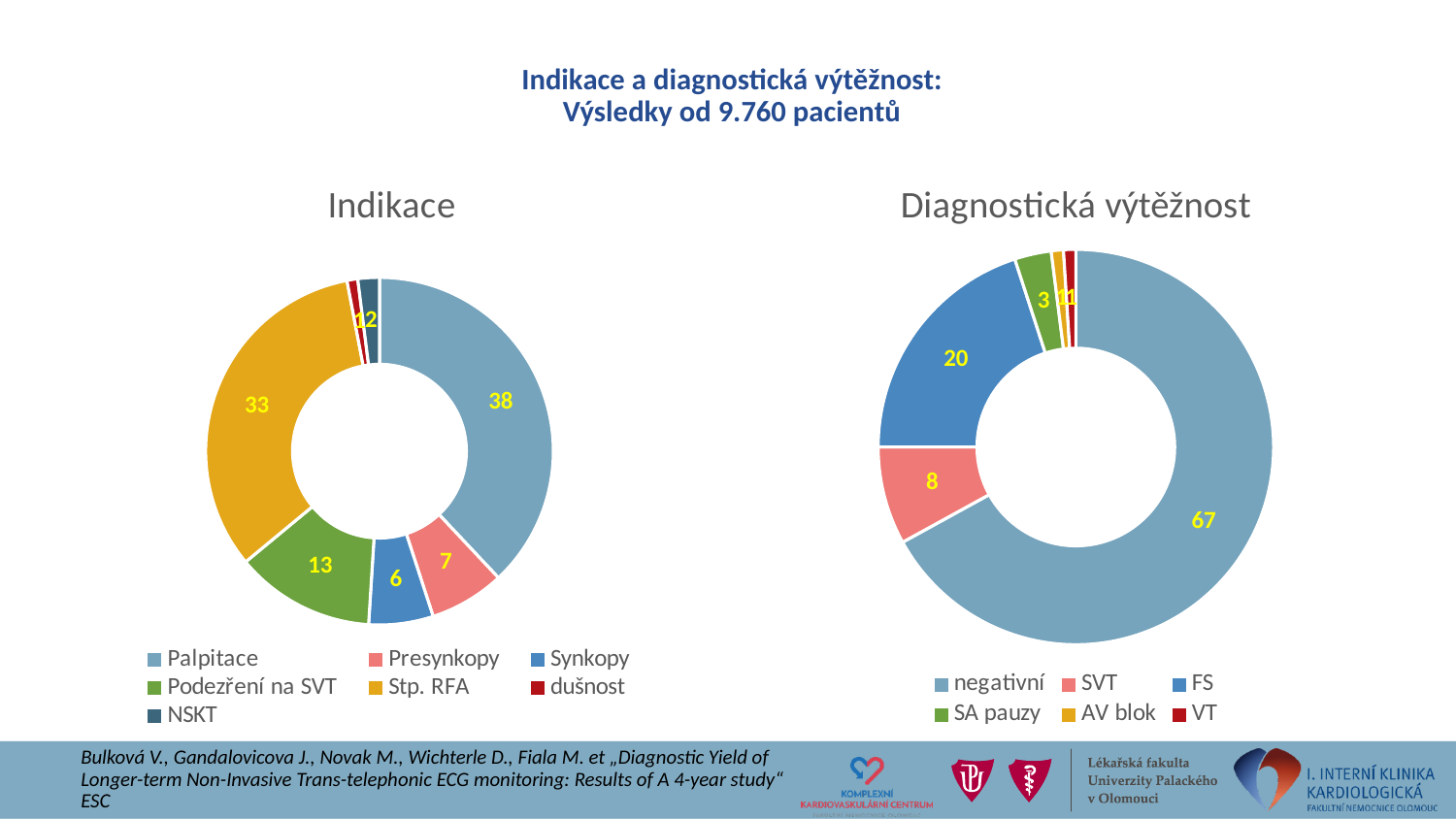
In the 'Diagnostická výtěžnost' chart, what is the value for FS? 20 What type of chart is the 'Diagnostická výtěžnost' chart? Doughnut chart In the 'Diagnostická výtěžnost' chart, what is the value for negativní? 67 In the 'Indikace' chart, what is the value for Palpitace? 38 How many categories does the legend of the 'Indikace' chart list? 7 In the 'Indikace' chart, what is the value for Stp. RFA? 33 In the 'Indikace' chart, which category has the highest value? Palpitace In the 'Diagnostická výtěžnost' chart, which category has the highest value? negativní In the 'Indikace' chart, what is the value for Podezření na SVT? 13 In the 'Indikace' chart, what is the difference between Palpitace and Stp. RFA? 5 In the 'Indikace' chart, which is larger, Presynkopy or Synkopy? Presynkopy In the 'Diagnostická výtěžnost' chart, what is the difference between FS and SVT? 12